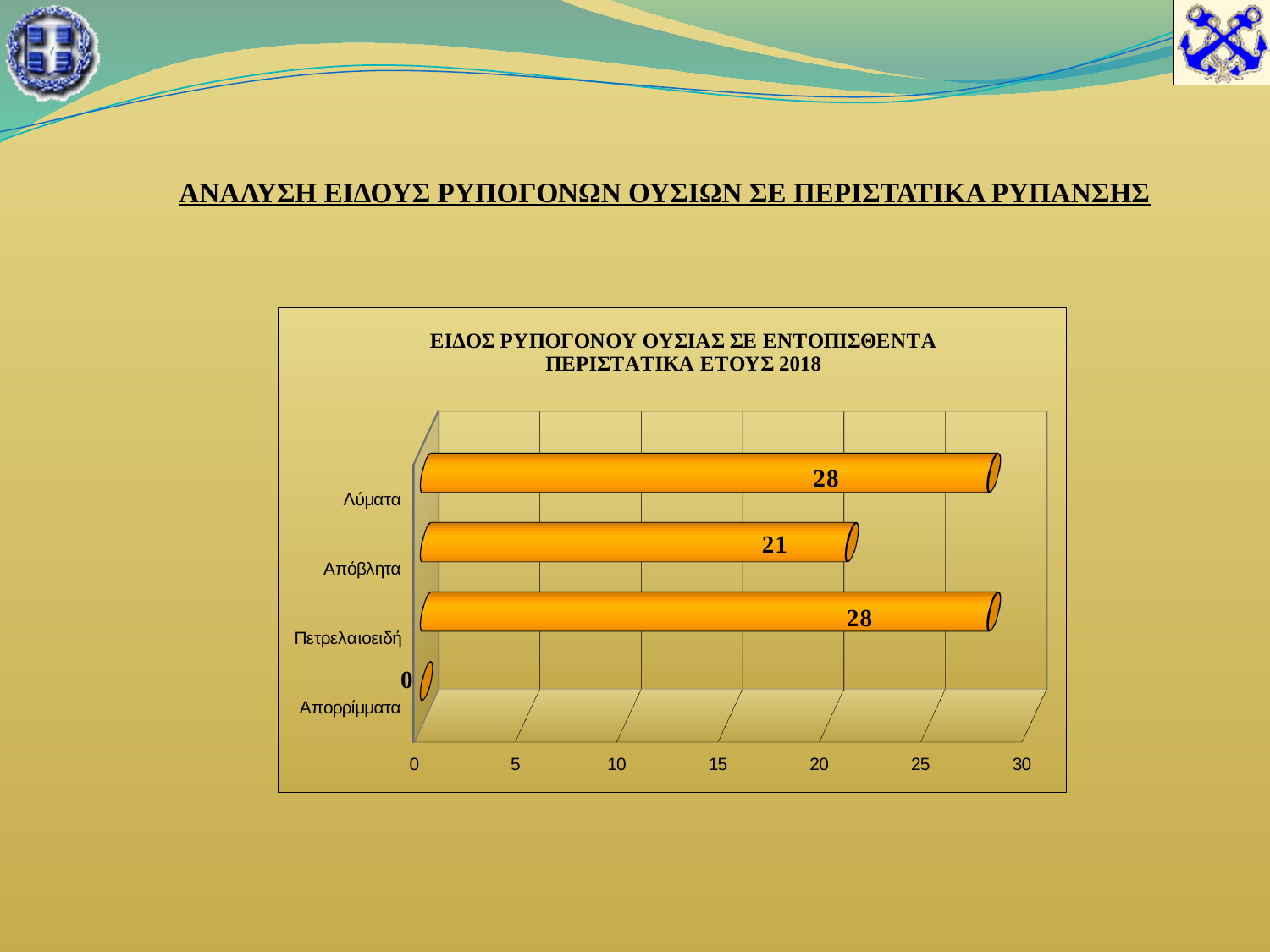
Is the value for Απόβλητα greater or less than 20? greater What is the value for Απόβλητα? 21 Which year does the chart title refer to? 2018 What is the value for Απορρίμματα? 0 How many categories are shown in the chart? 4 What is the value for Πετρελαιοειδή? 28 What is the difference between the values for Λύματα and Απόβλητα? 7 Which category has the lowest value? Απορρίμματα What kind of chart is shown on the slide? bar chart Which is larger, the value for Πετρελαιοειδή or the value for Απόβλητα? Πετρελαιοειδή What is the value for Λύματα? 28 What is the difference between the values for Πετρελαιοειδή and Απορρίμματα? 28